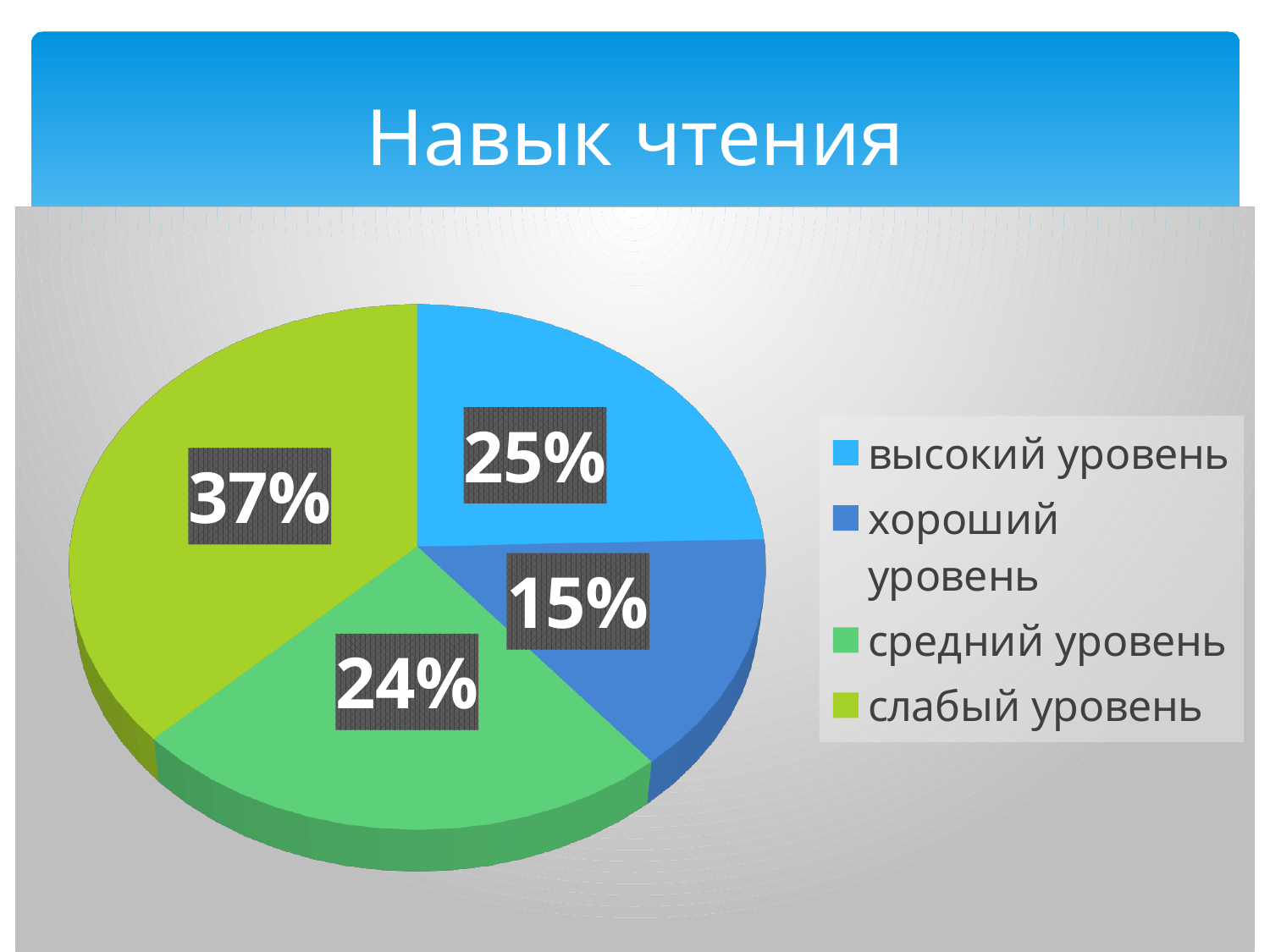
What is the difference in percentage points between "слабый уровень" and "хороший уровень"? 22 Which category has the largest slice of the pie? слабый уровень What share of the pie does "слабый уровень" have? 37% Which colour represents "слабый уровень" in the legend? yellow-green What is the title of the chart? Навык чтения Which is larger, the slice for "высокий уровень" or the slice for "средний уровень"? высокий уровень What share of the pie does "высокий уровень" have? 25% What share of the pie does "средний уровень" have? 24% Which category has the smallest slice of the pie? хороший уровень What kind of chart is shown on the slide? pie chart How many categories does the pie chart show? 4